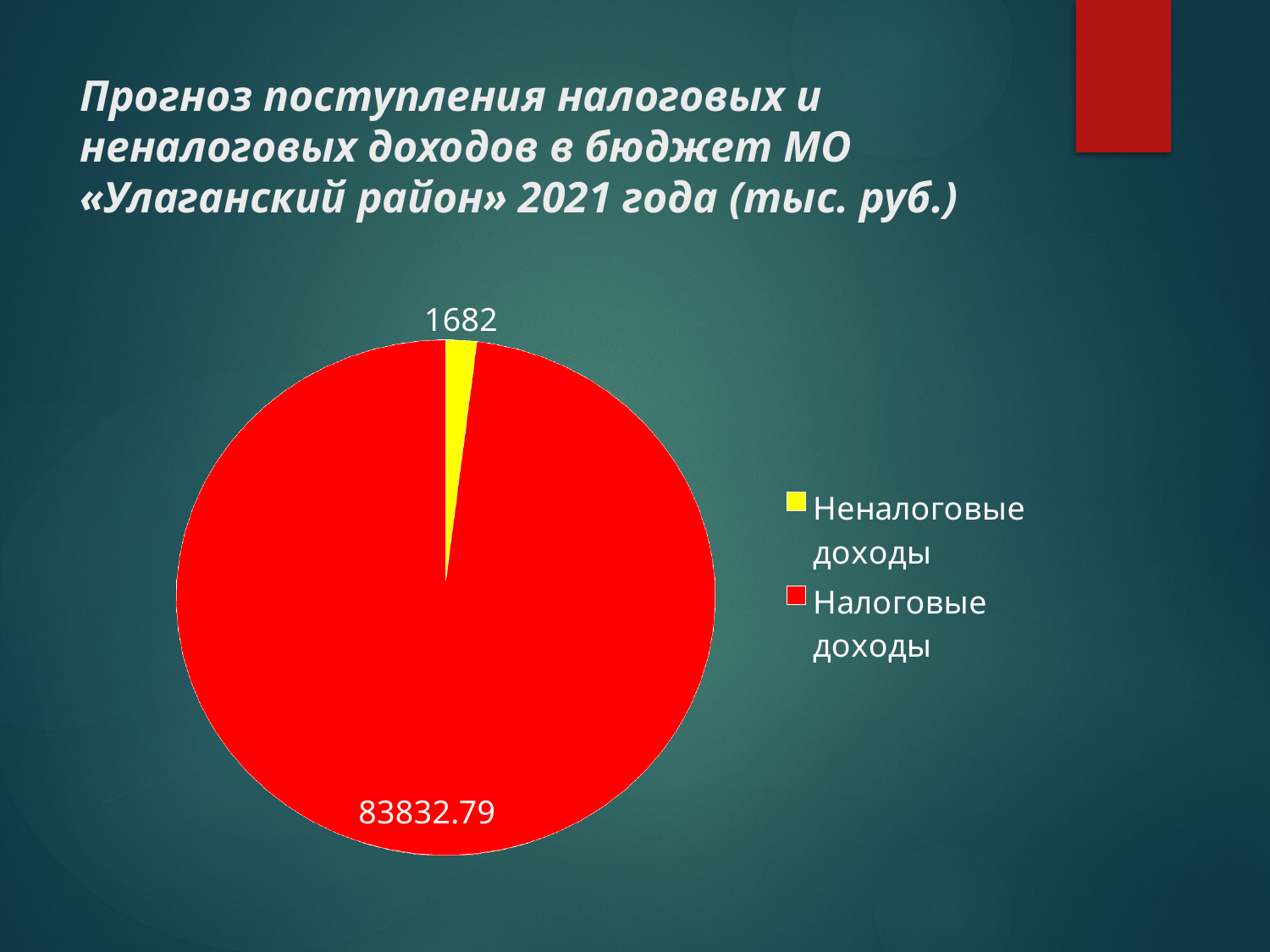
Which category has the largest slice of the pie? Налоговые доходы How many categories does the pie chart show? 2 What unit is stated in the chart title? тыс. руб. What type of chart is shown on the slide? pie chart Which category has the smallest slice of the pie? Неналоговые доходы What is the total of all slices in the pie chart? 85514.79 Which is larger, Налоговые доходы or Неналоговые доходы? Налоговые доходы What colour is the slice for Неналоговые доходы? yellow What is the value for Налоговые доходы? 83832.79 What is the value for Неналоговые доходы? 1682 What is the difference between the value for Налоговые доходы and the value for Неналоговые доходы? 82150.79